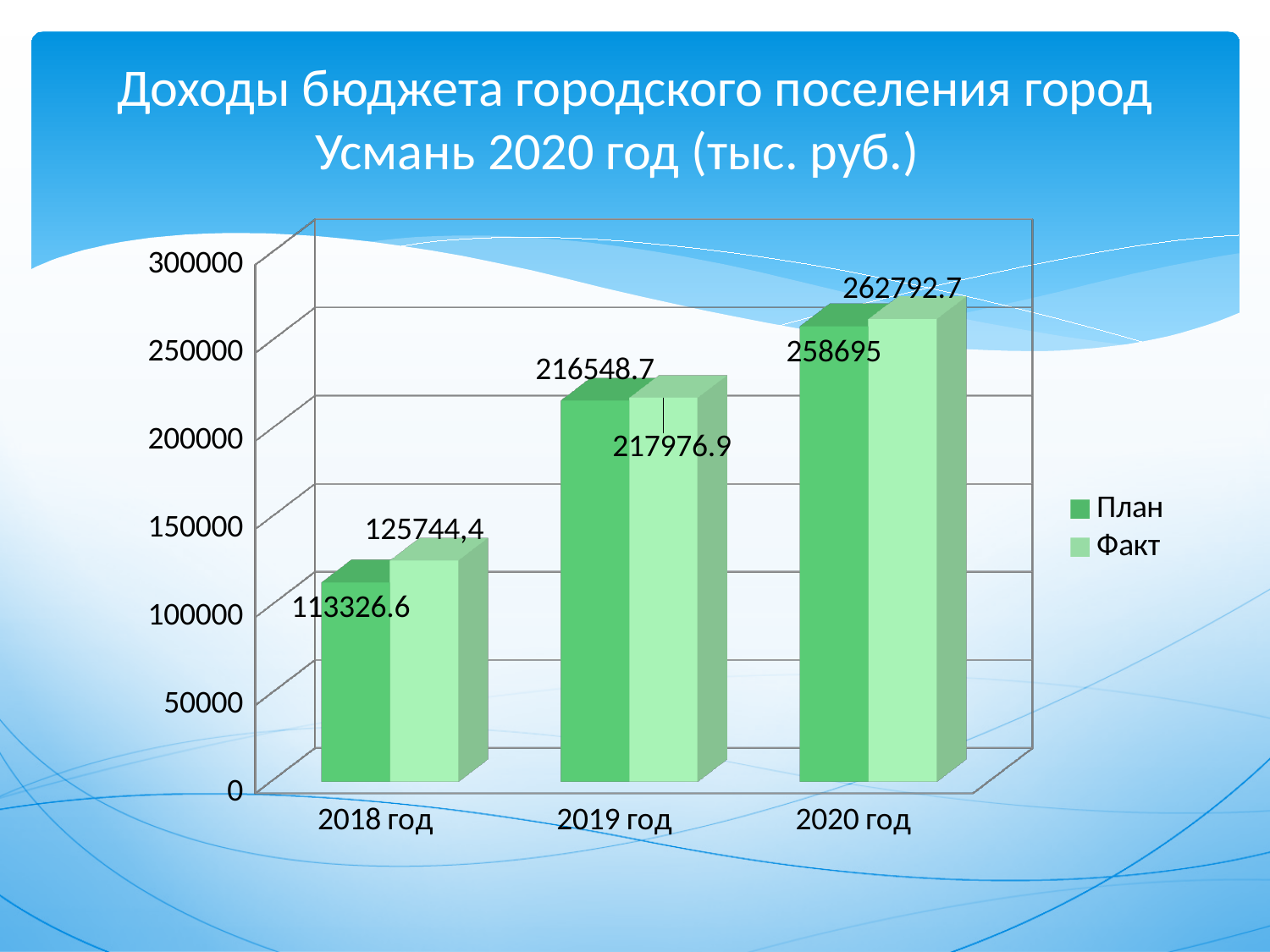
How many series does the legend list? 2 What is the План value for 2019 год? 216548.7 Which year has the lowest План value? 2018 год What type of chart is shown on the slide? Bar chart What is the Факт value for 2020 год? 262792.7 How many year categories are shown on the x axis? 3 Which series is shown in the lighter green colour? Факт Do the План values rise or fall from 2018 год to 2020 год? Rise What is the difference between the Факт and План values for 2020 год? 4097.7 What is the Факт value for 2018 год? 125744,4 Which year has the highest Факт value? 2020 год What is the План value for 2018 год? 113326.6